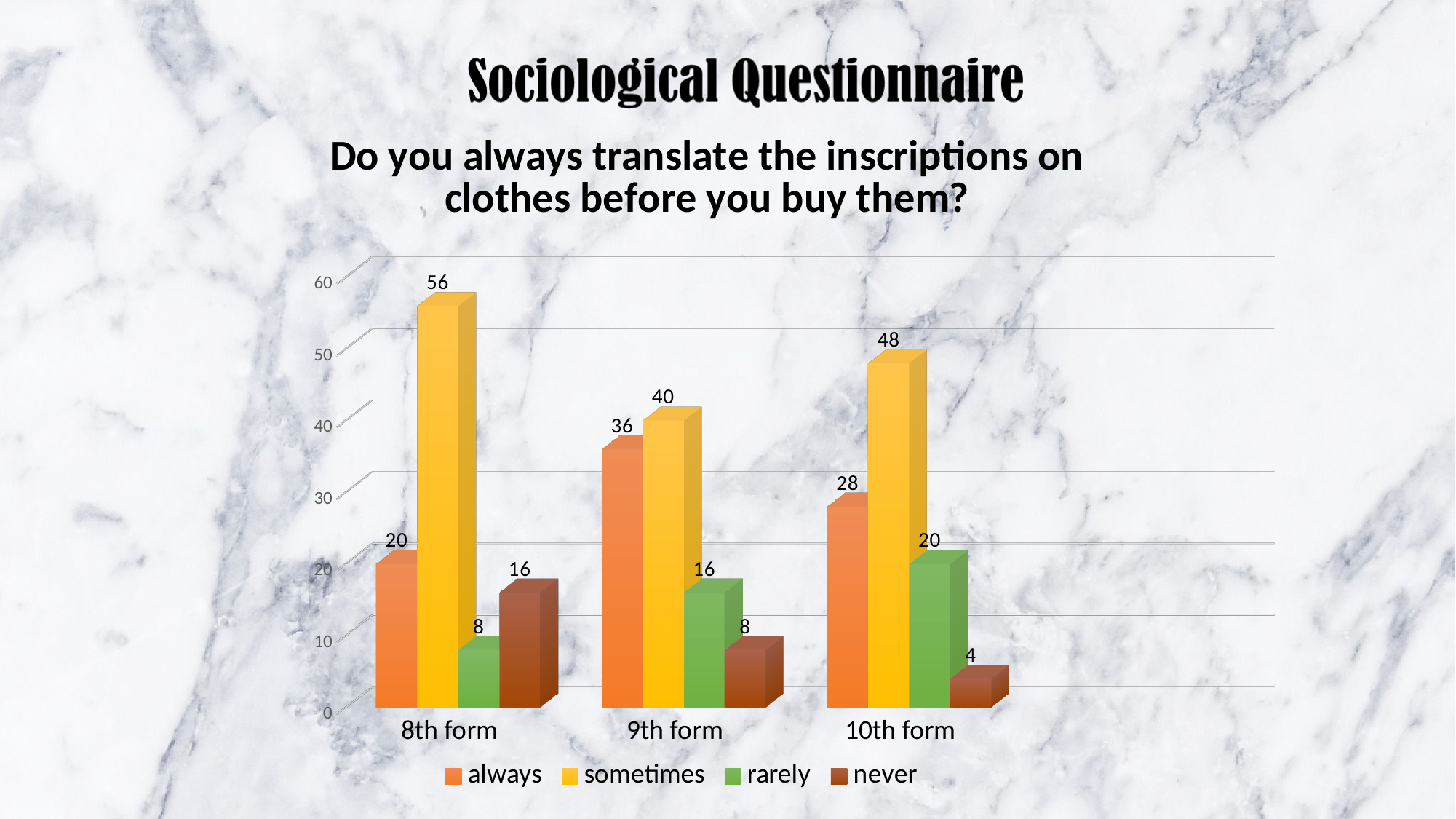
How many series does the legend list? 4 What is the difference between the "sometimes" and "always" values in the 8th form? 36 What is the value for "always" in the 9th form? 36 Which form has the highest value for "sometimes"? 8th form What kind of chart is shown on the slide? Bar chart Which form has the lowest value for "never"? 10th form What is the value for "never" in the 10th form? 4 What is the value for "sometimes" in the 8th form? 56 Does the value for "always" rise or fall from the 9th form to the 10th form? Fall Which is larger: "always" in the 9th form or "always" in the 10th form? 9th form How many forms (categories) are shown on the x axis? 3 What is the value for "rarely" in the 10th form? 20